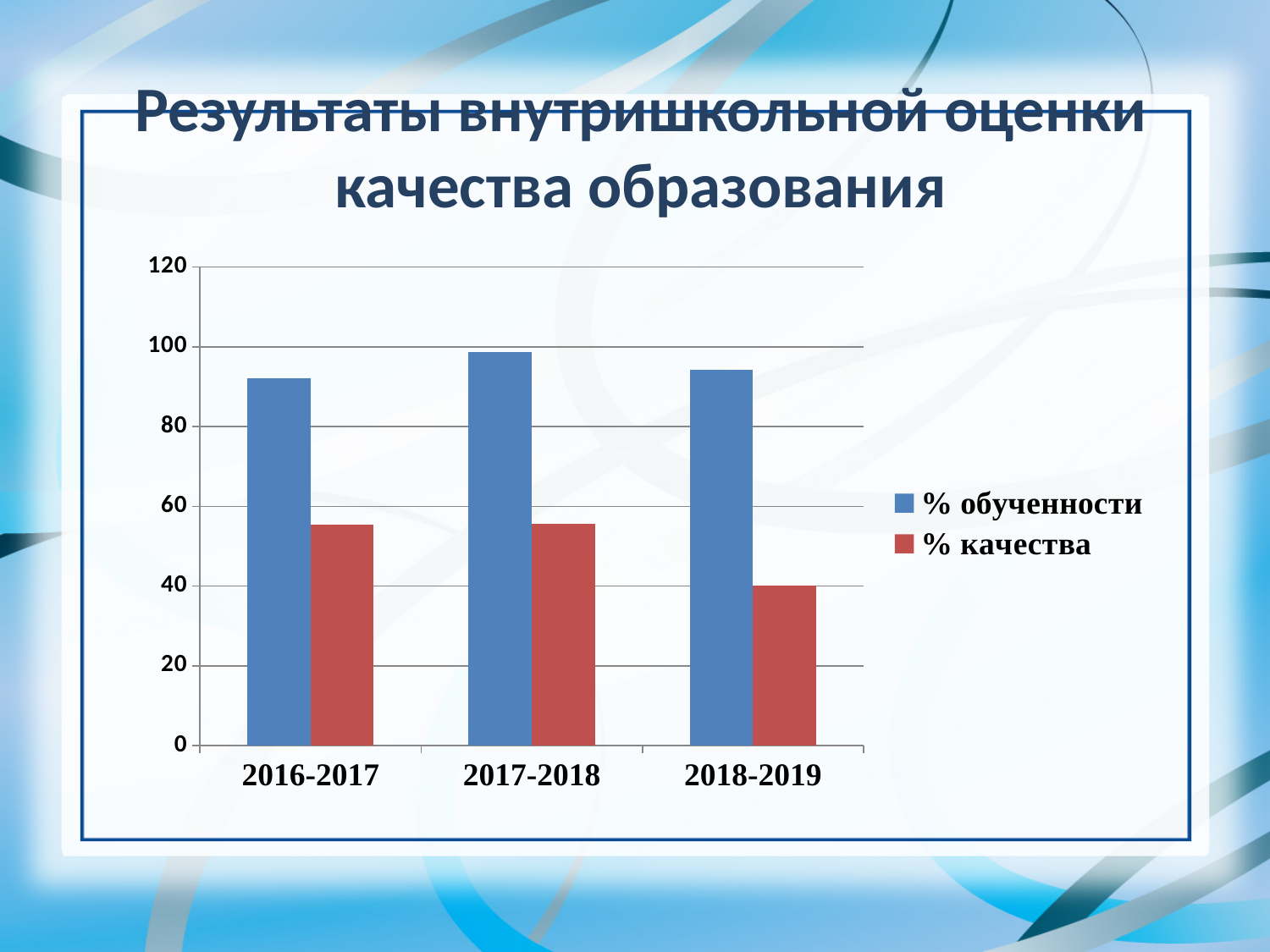
Is the value for % качества in 2018-2019 greater or less than 60? less Which school year has the highest value for % обученности? 2017-2018 Does the value for % качества rise or fall from 2017-2018 to 2018-2019? fall What colour are the bars for % качества? red Is the value for % обученности in 2016-2017 greater or less than 80? greater Is the value for % обученности in 2017-2018 greater or less than 100? less How many school years are shown on the x axis? 3 Which is larger: % обученности in 2017-2018 or % обученности in 2016-2017? 2017-2018 Which school year has the lowest value for % качества? 2018-2019 How many series does the legend list? 2 What kind of chart is shown on the slide? bar chart